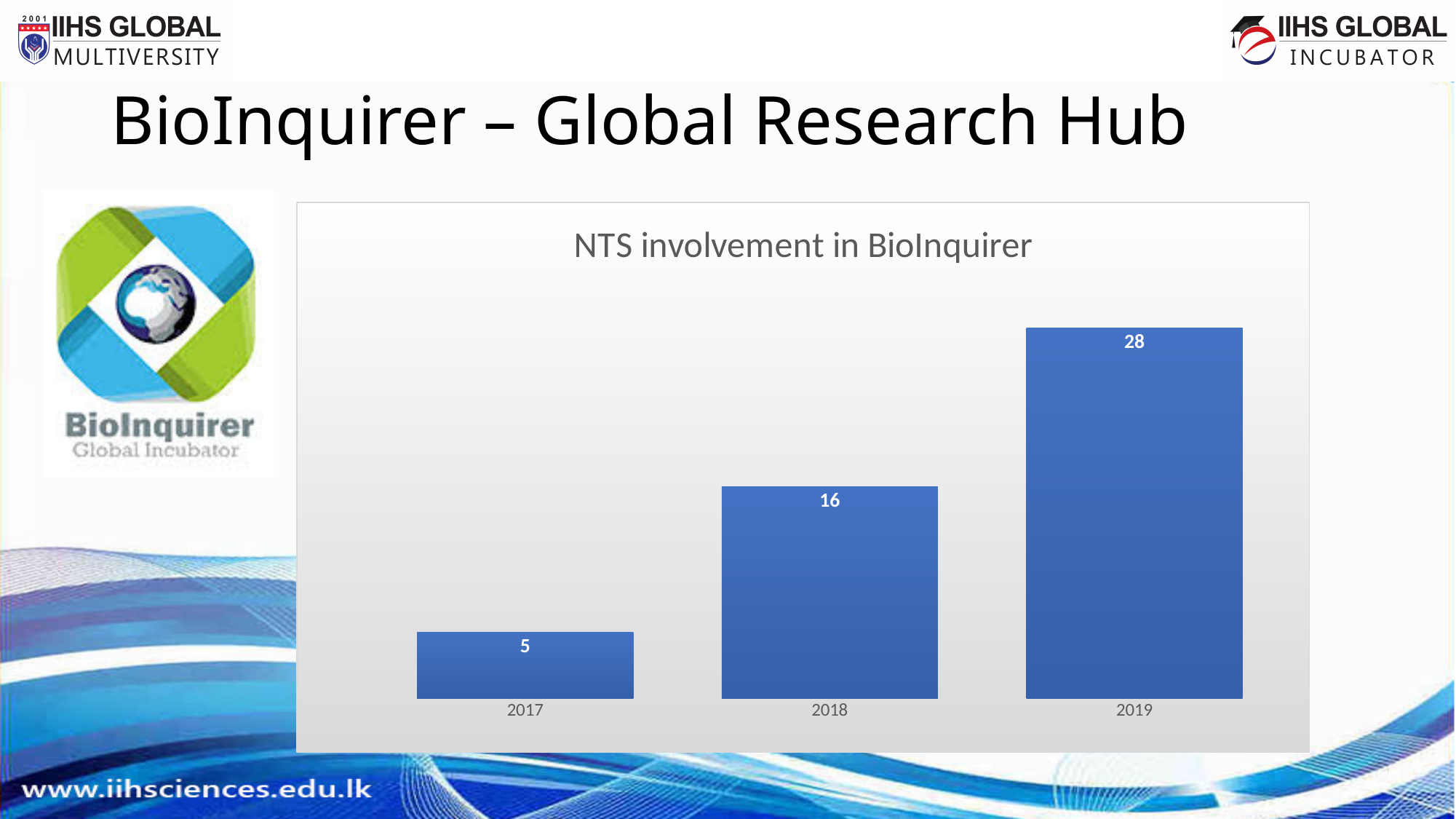
What is the title of the chart on the slide? NTS involvement in BioInquirer What is the value for 2017 in the NTS involvement in BioInquirer chart? 5 What is the value for 2018 in the NTS involvement in BioInquirer chart? 16 Which year has the highest value in the NTS involvement in BioInquirer chart? 2019 What is the difference between the values for 2018 and 2017 in the NTS involvement in BioInquirer chart? 11 Do the values in the NTS involvement in BioInquirer chart rise or fall from 2017 to 2019? Rise What is the difference between the values for 2019 and 2018 in the NTS involvement in BioInquirer chart? 12 What kind of chart is the NTS involvement in BioInquirer chart? Bar chart How many years are shown in the NTS involvement in BioInquirer chart? 3 Which year has the lowest value in the NTS involvement in BioInquirer chart? 2017 What is the value for 2019 in the NTS involvement in BioInquirer chart? 28 Which is larger in the NTS involvement in BioInquirer chart, the value for 2017 or the value for 2018? 2018